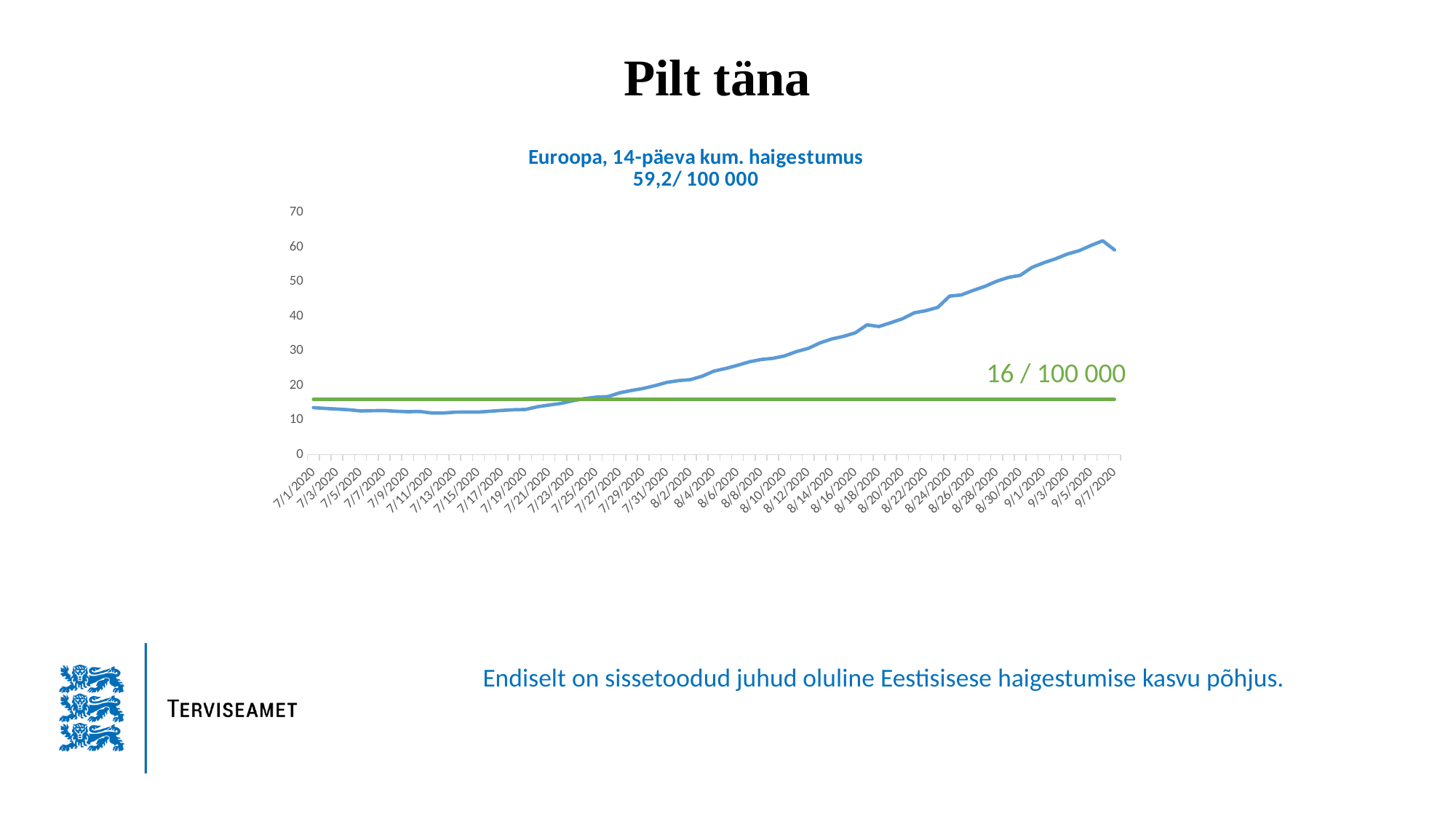
Is the value of the blue line on 7/1/2020 greater or less than 20? less Is the value of the blue line on 9/7/2020 greater or less than 50? greater What is the title of the chart? Euroopa, 14-päeva kum. haigestumus 59,2/ 100 000 Does the blue line generally rise or fall from 7/1/2020 to 9/5/2020? rise What value is the green horizontal line labelled with? 16 / 100 000 Is the blue line on 9/7/2020 higher or lower than on 9/5/2020? lower What is the highest value shown on the vertical axis? 70 Is the value of the blue line on 8/10/2020 greater or less than 20? greater What kind of chart is shown on the slide? line chart What 14-day cumulative incidence for Europe is stated in the chart title? 59,2/ 100 000